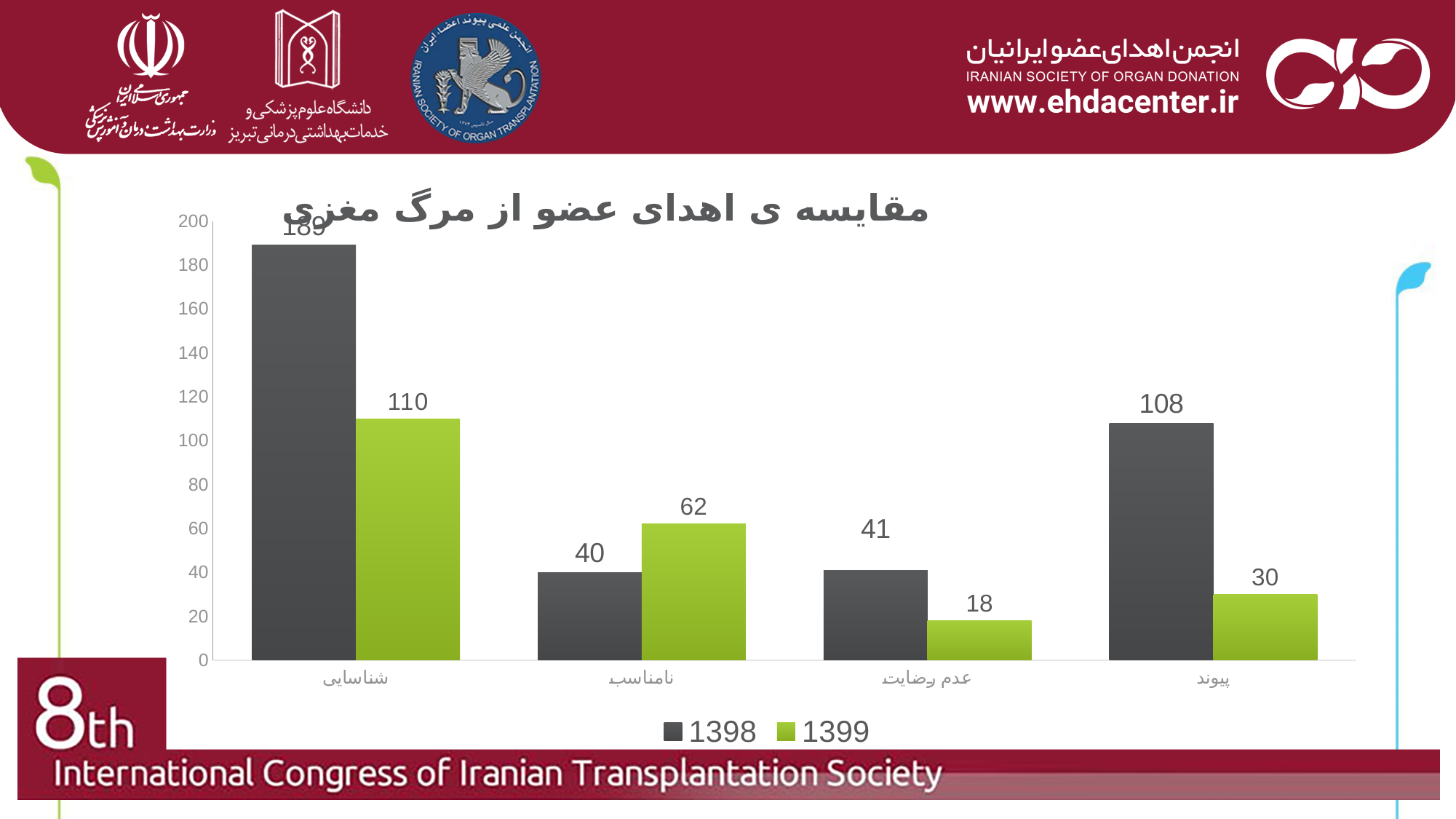
What is the difference between the 1398 and 1399 values in the پیوند category? 78 In the نامناسب category, which series has the larger value, 1398 or 1399? 1399 What is the value for 1399 in the شناسایی category? 110 Is the value for 1398 in the شناسایی category greater or less than 180? greater What is the value for 1399 in the عدم رضایت category? 18 What is the value for 1398 in the نامناسب category? 40 How many categories are shown on the x axis? 4 Which category has the lowest value for the 1399 series? عدم رضایت How many series does the legend list? 2 What kind of chart is shown on the slide? bar chart Which category has the highest value for the 1398 series? شناسایی What is the value for 1398 in the پیوند category? 108